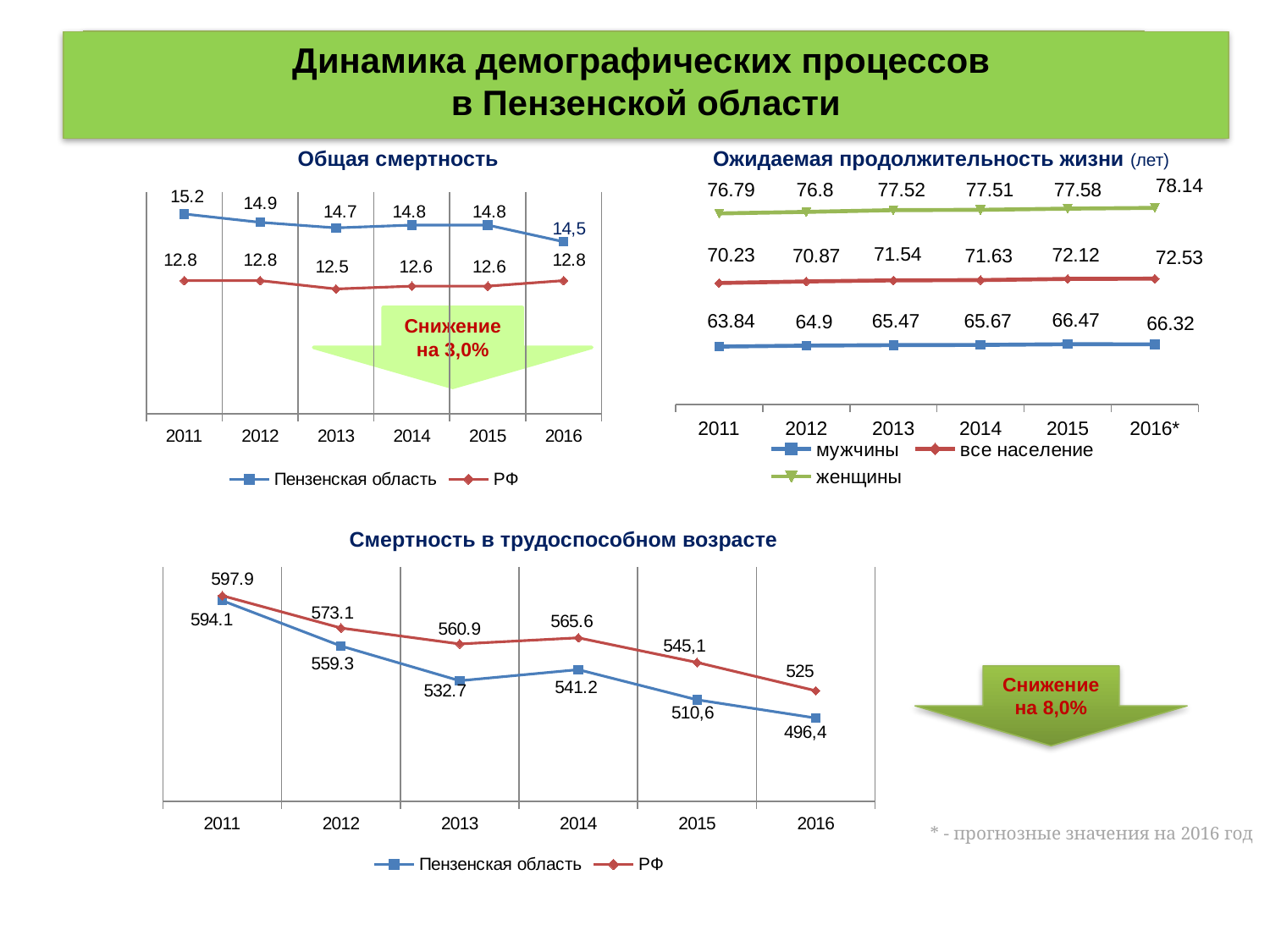
In the chart 'Смертность в трудоспособном возрасте', which is larger in 2013: Пензенская область or РФ? РФ In the chart 'Ожидаемая продолжительность жизни', how many series does the legend list? 3 What kind of chart is 'Смертность в трудоспособном возрасте'? Line chart In the chart 'Ожидаемая продолжительность жизни', what is the value for мужчины in 2015? 66.47 In the chart 'Ожидаемая продолжительность жизни', what is the value for женщины in 2016*? 78.14 In the chart 'Ожидаемая продолжительность жизни', in which year is the value for все население highest? 2016* In the chart 'Общая смертность', what is the difference between Пензенская область and РФ in 2016? 1.7 In the chart 'Общая смертность', what is the value for РФ in 2013? 12.5 In the chart 'Смертность в трудоспособном возрасте', in which year is the value for Пензенская область lowest? 2016 In the chart 'Общая смертность', what is the value for Пензенская область in 2011? 15.2 In the chart 'Смертность в трудоспособном возрасте', what is the value for РФ in 2014? 565.6 In the chart 'Общая смертность', how many series does the legend list? 2